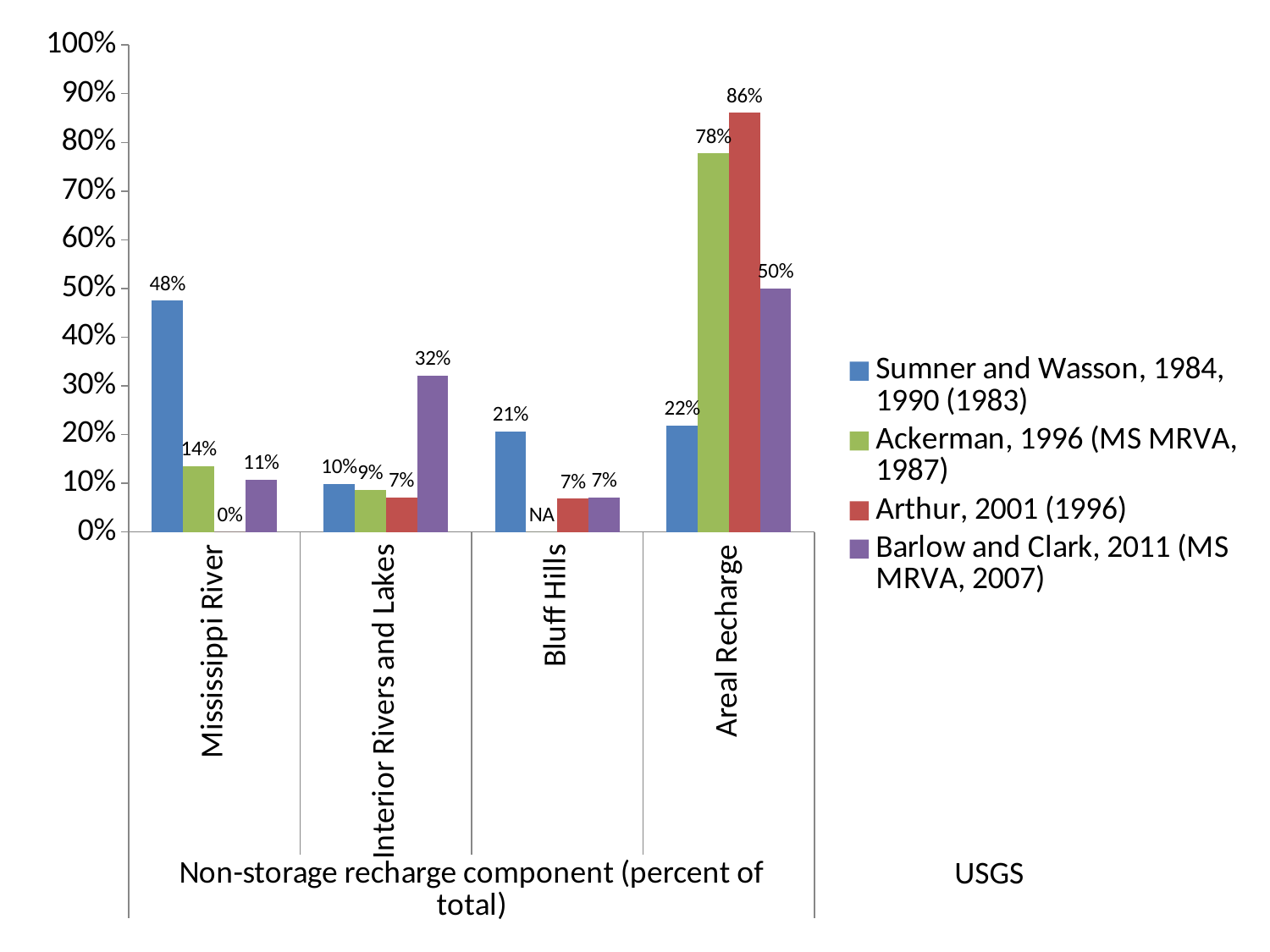
What is the difference between the Arthur, 2001 (1996) and Ackerman, 1996 (MS MRVA, 1987) values for Areal Recharge? 8% Which category has the lowest value for Sumner and Wasson, 1984, 1990 (1983)? Interior Rivers and Lakes How many categories are shown on the x axis? 4 What is the x-axis title of the chart? Non-storage recharge component (percent of total) Which category has the highest value for Ackerman, 1996 (MS MRVA, 1987)? Areal Recharge What label is shown for Ackerman, 1996 (MS MRVA, 1987) in the Bluff Hills category? NA How many series does the legend list? 4 What is the value for Sumner and Wasson, 1984, 1990 (1983) for Mississippi River? 48% For Mississippi River, which is larger: the Ackerman, 1996 (MS MRVA, 1987) value or the Barlow and Clark, 2011 (MS MRVA, 2007) value? Ackerman, 1996 (MS MRVA, 1987) What is the value for Arthur, 2001 (1996) for Areal Recharge? 86% What is the value for Barlow and Clark, 2011 (MS MRVA, 2007) for Interior Rivers and Lakes? 32% What kind of chart is shown on the slide? bar chart